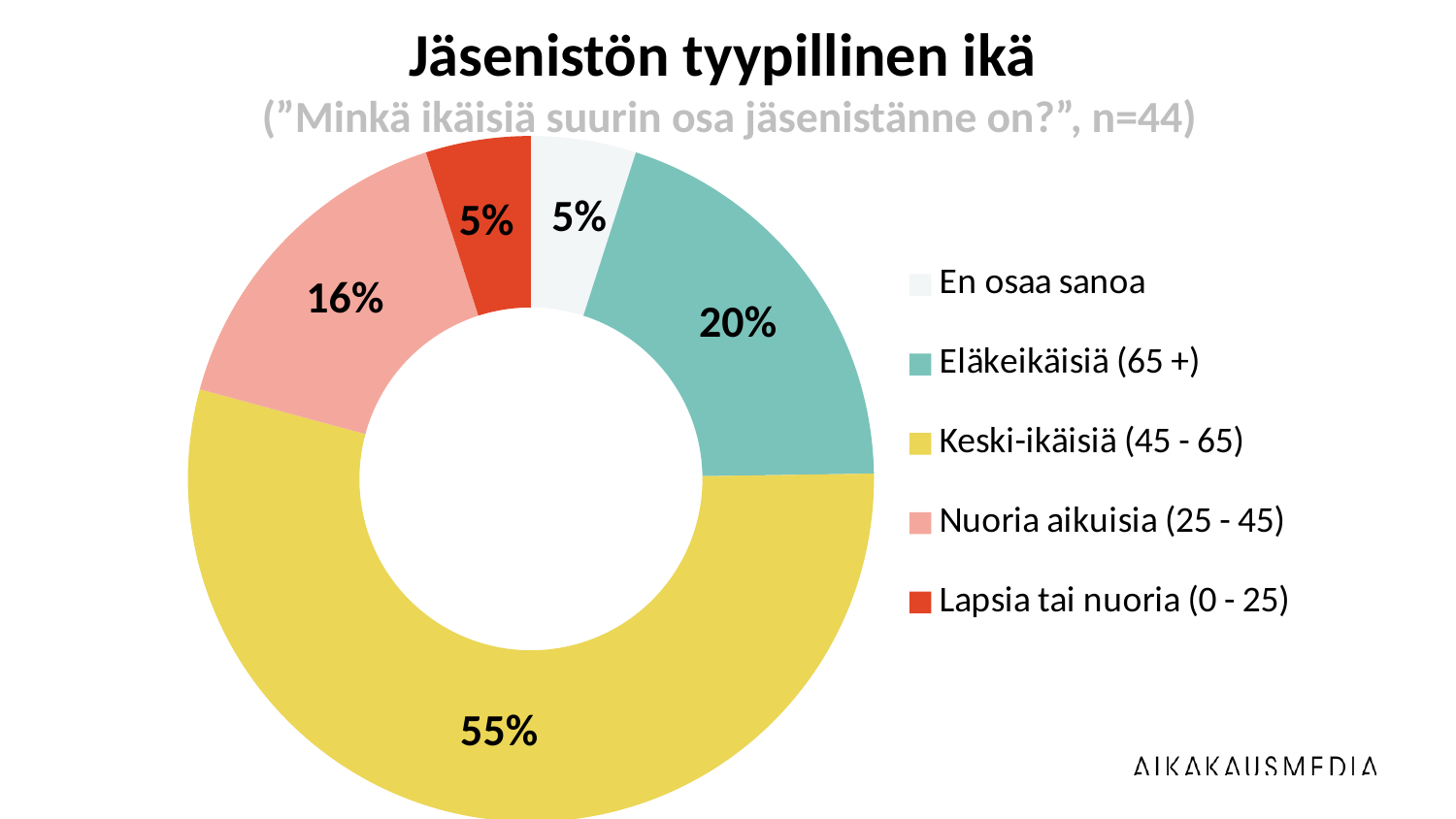
Which category has the largest share? Keski-ikäisiä (45 - 65) What kind of chart is shown on the slide? Pie chart (doughnut) What is the difference between Eläkeikäisiä (65 +) and Nuoria aikuisia (25 - 45)? 4% How many categories does the chart show? 5 Which is larger, Eläkeikäisiä (65 +) or Nuoria aikuisia (25 - 45)? Eläkeikäisiä (65 +) What is the value for En osaa sanoa? 5% What is the value for Eläkeikäisiä (65 +)? 20% What is the value for Lapsia tai nuoria (0 - 25)? 5% What is the difference between Keski-ikäisiä (45 - 65) and Eläkeikäisiä (65 +)? 35% What share of the chart does Keski-ikäisiä (45 - 65) represent? 55% What is the title of the chart? Jäsenistön tyypillinen ikä What is the value for Nuoria aikuisia (25 - 45)? 16%